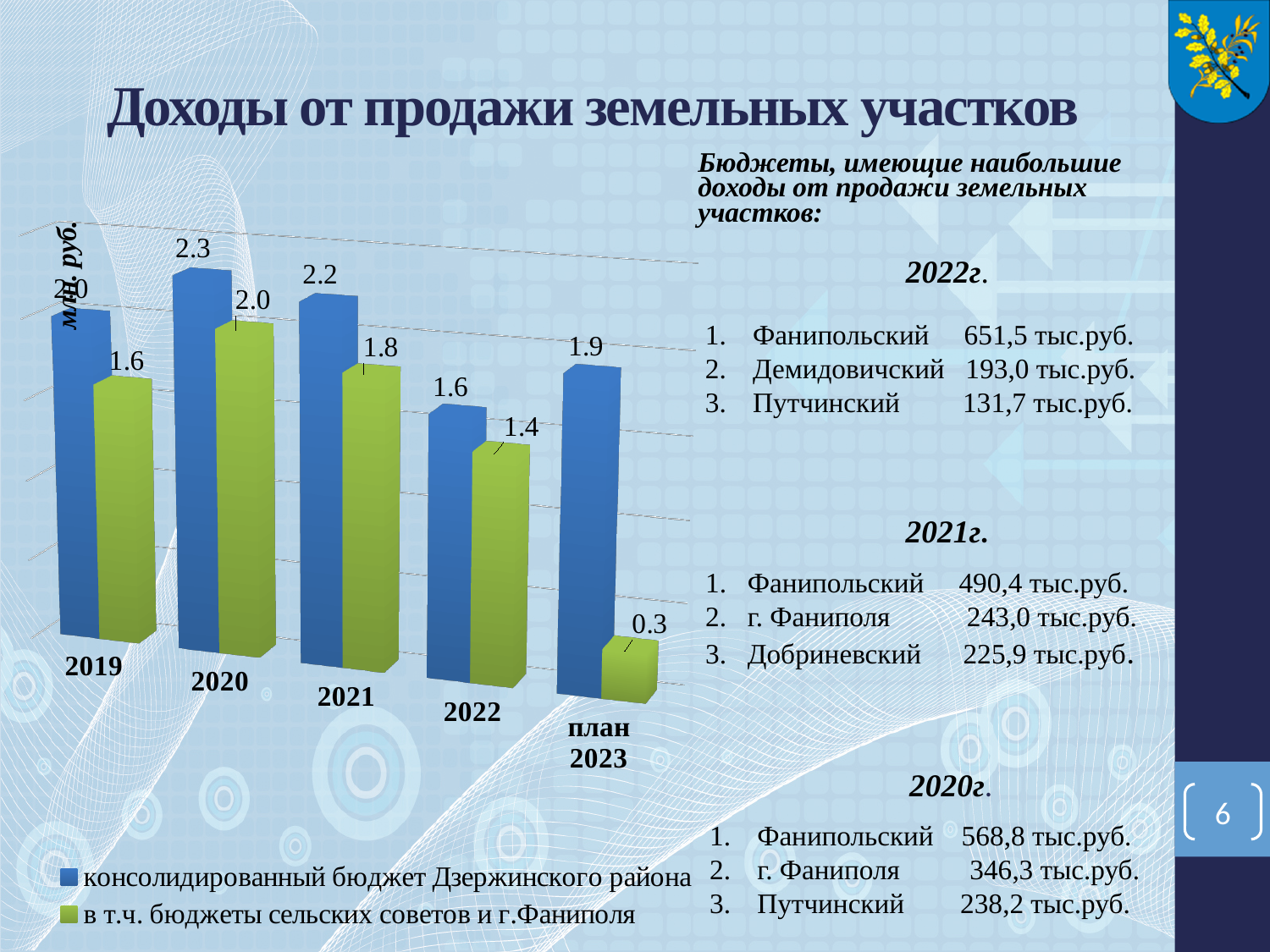
What is the value for бюджеты сельских советов и г.Фаниполя in 2021? 1.8 How many year categories are shown on the x axis of the chart? 5 How many series does the chart legend list? 2 What is the value for консолидированный бюджет Дзержинского района in 2020? 2.3 In which category is the бюджеты сельских советов и г.Фаниполя value lowest? план 2023 What is the value for бюджеты сельских советов и г.Фаниполя in план 2023? 0.3 What is the difference between the консолидированный бюджет and the бюджеты сельских советов values in план 2023? 1.6 Which is larger: the бюджеты сельских советов и г.Фаниполя value in 2020 or in 2022? 2020 What is the value for консолидированный бюджет Дзержинского района in 2022? 1.6 What type of chart is shown on the slide? bar chart In which year is the консолидированный бюджет Дзержинского района value highest? 2020 What unit is shown on the vertical axis label of the chart? млн. руб.